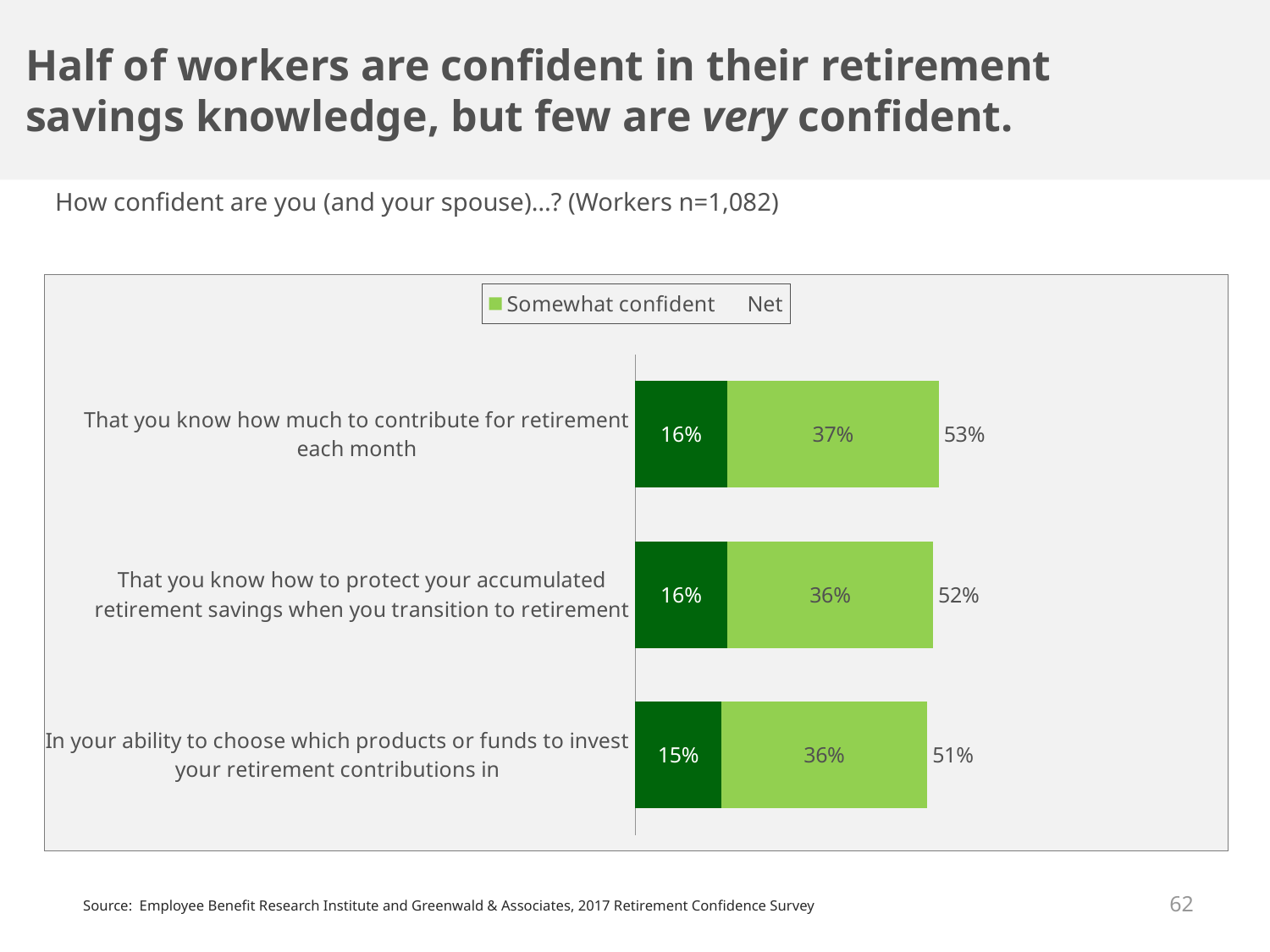
What is the difference between the Net value for 'That you know how much to contribute for retirement each month' and the Net value for 'In your ability to choose which products or funds to invest your retirement contributions in'? 2 percentage points What are the two entries listed in the chart legend? Somewhat confident and Net What value is shown in the dark green segment for 'In your ability to choose which products or funds to invest your retirement contributions in'? 15% Which has the larger 'Somewhat confident' value: 'That you know how much to contribute for retirement each month' or 'That you know how to protect your accumulated retirement savings when you transition to retirement'? That you know how much to contribute for retirement each month Which category has the lowest Net value? In your ability to choose which products or funds to invest your retirement contributions in Which category has the highest Net value? That you know how much to contribute for retirement each month What is the 'Somewhat confident' value for 'That you know how much to contribute for retirement each month'? 37% What is the total of the two bar segments (16% and 37%) for 'That you know how much to contribute for retirement each month'? 53% How many categories are shown in the chart? 3 How many entries does the chart legend list? 2 What kind of chart is shown on the slide? Stacked bar chart What is the Net value for 'That you know how to protect your accumulated retirement savings when you transition to retirement'? 52%